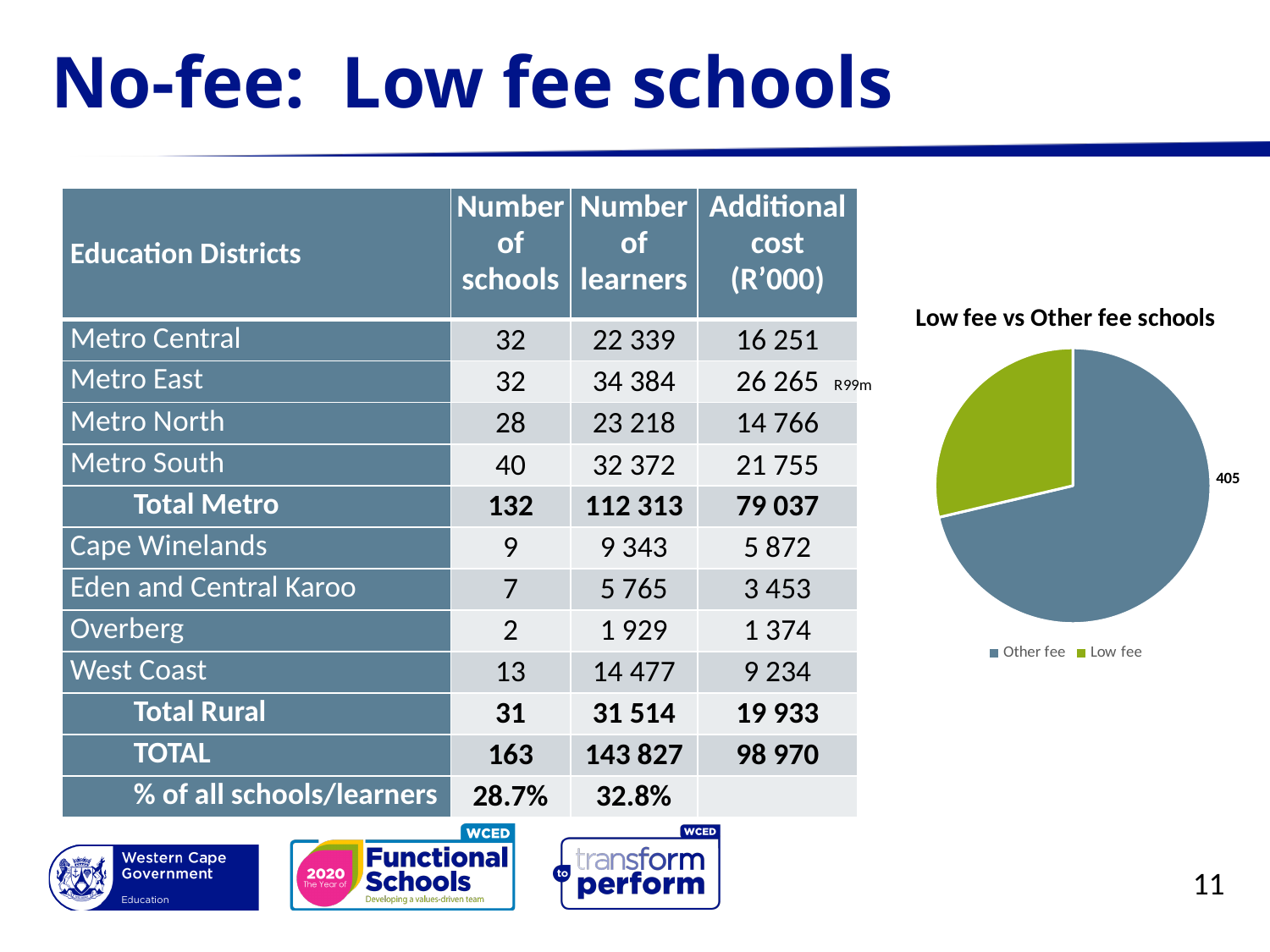
What kind of chart is shown on the slide? pie chart How many categories does the legend of the pie chart list? 2 Does the Low fee slice make up more or less than half of the pie chart? less than half Which is larger in the pie chart, Other fee or Low fee? Other fee What colour is the Low fee slice in the pie chart? green Which slice of the pie chart is the smallest? Low fee Which slice of the pie chart is the largest? Other fee What is the title of the chart on the slide? Low fee vs Other fee schools What value is labelled on the Other fee slice of the pie chart? 405